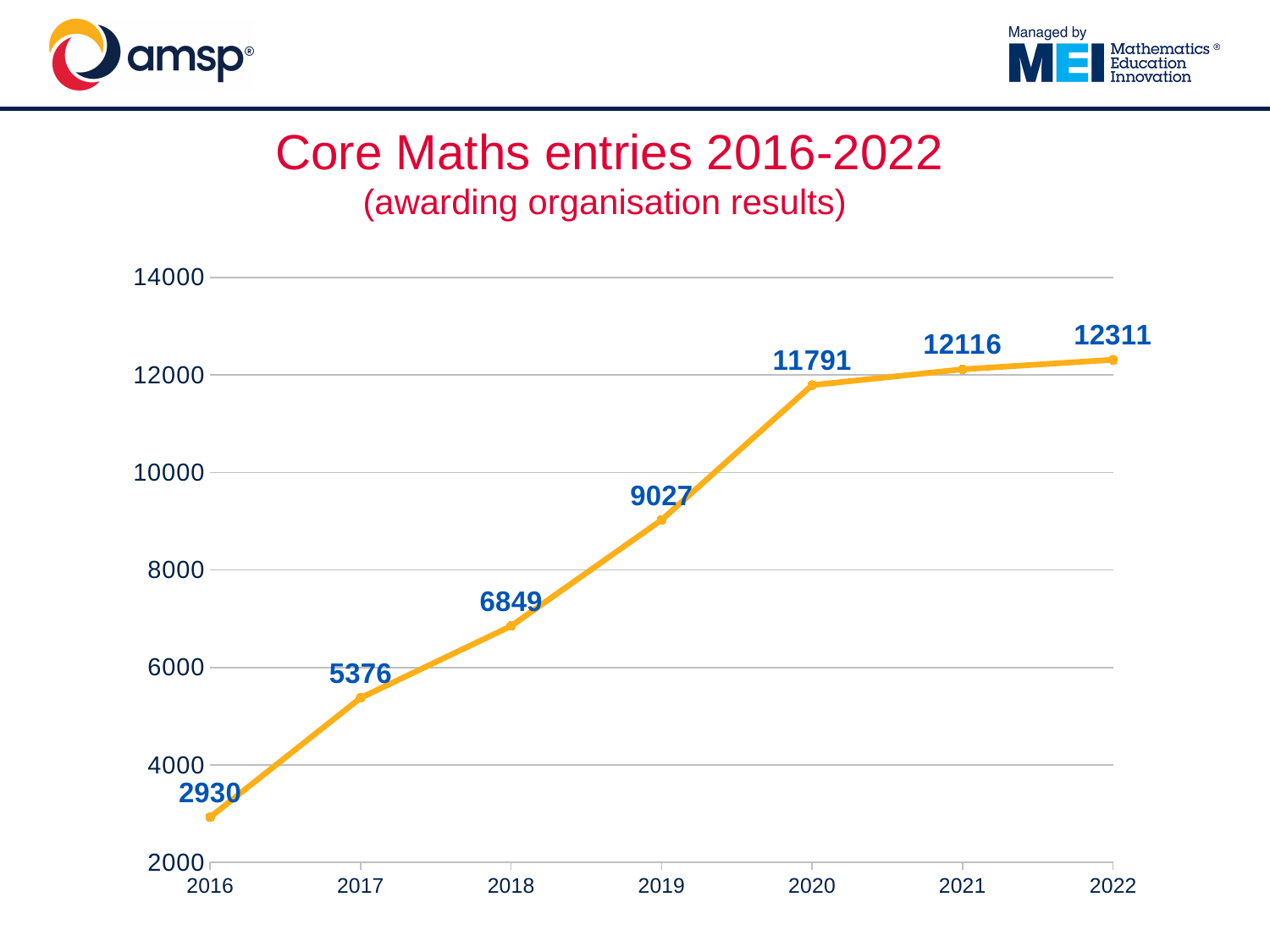
Is the number of Core Maths entries in 2021 greater or less than 12000? greater Which year has the highest number of Core Maths entries? 2022 What is the number of Core Maths entries in 2022? 12311 What is the difference in Core Maths entries between 2020 and 2019? 2764 What kind of chart is shown on the slide? line chart Do Core Maths entries rise or fall from 2016 to 2022? rise How many years are plotted on the chart? 7 What is the number of Core Maths entries in 2016? 2930 Which year has more Core Maths entries, 2017 or 2018? 2018 What is the number of Core Maths entries in 2019? 9027 Which year has the lowest number of Core Maths entries? 2016 What is the difference in Core Maths entries between 2022 and 2016? 9381